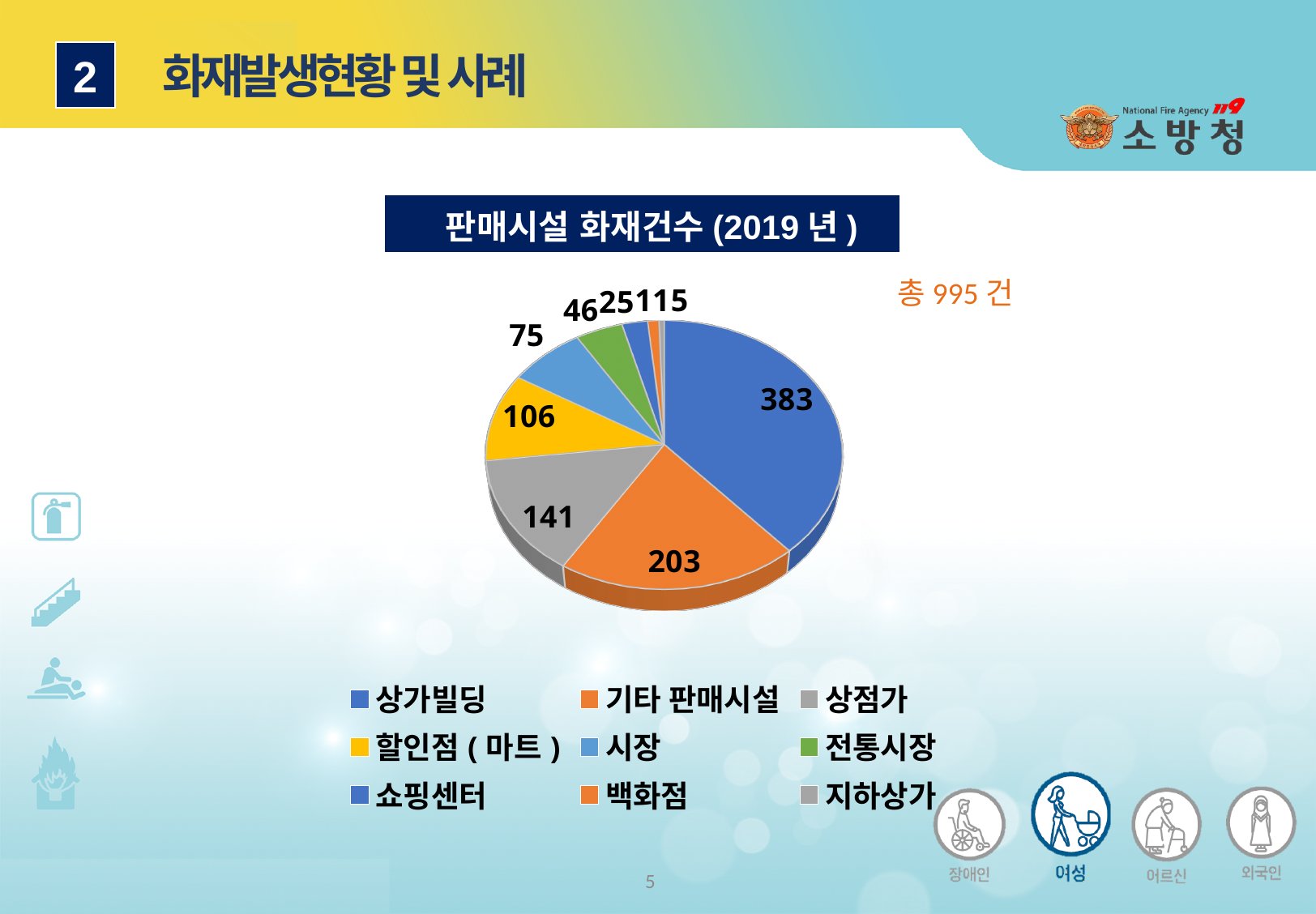
What is the number of fires for 기타 판매시설? 203 What is the number of fires for 상가빌딩? 383 What type of chart is shown on the slide? pie chart Which category has the largest slice of the pie? 상가빌딩 What is the total number of fires shown on the slide? 995 건 What is the number of fires for 시장? 75 What is the difference between the values for 상가빌딩 and 기타 판매시설? 180 What is the title of the chart? 판매시설 화재건수 (2019 년) How many categories does the legend of the pie chart list? 9 What is the number of fires for 할인점 (마트)? 106 Which category has the smallest slice of the pie? 지하상가 What is the number of fires for 상점가? 141